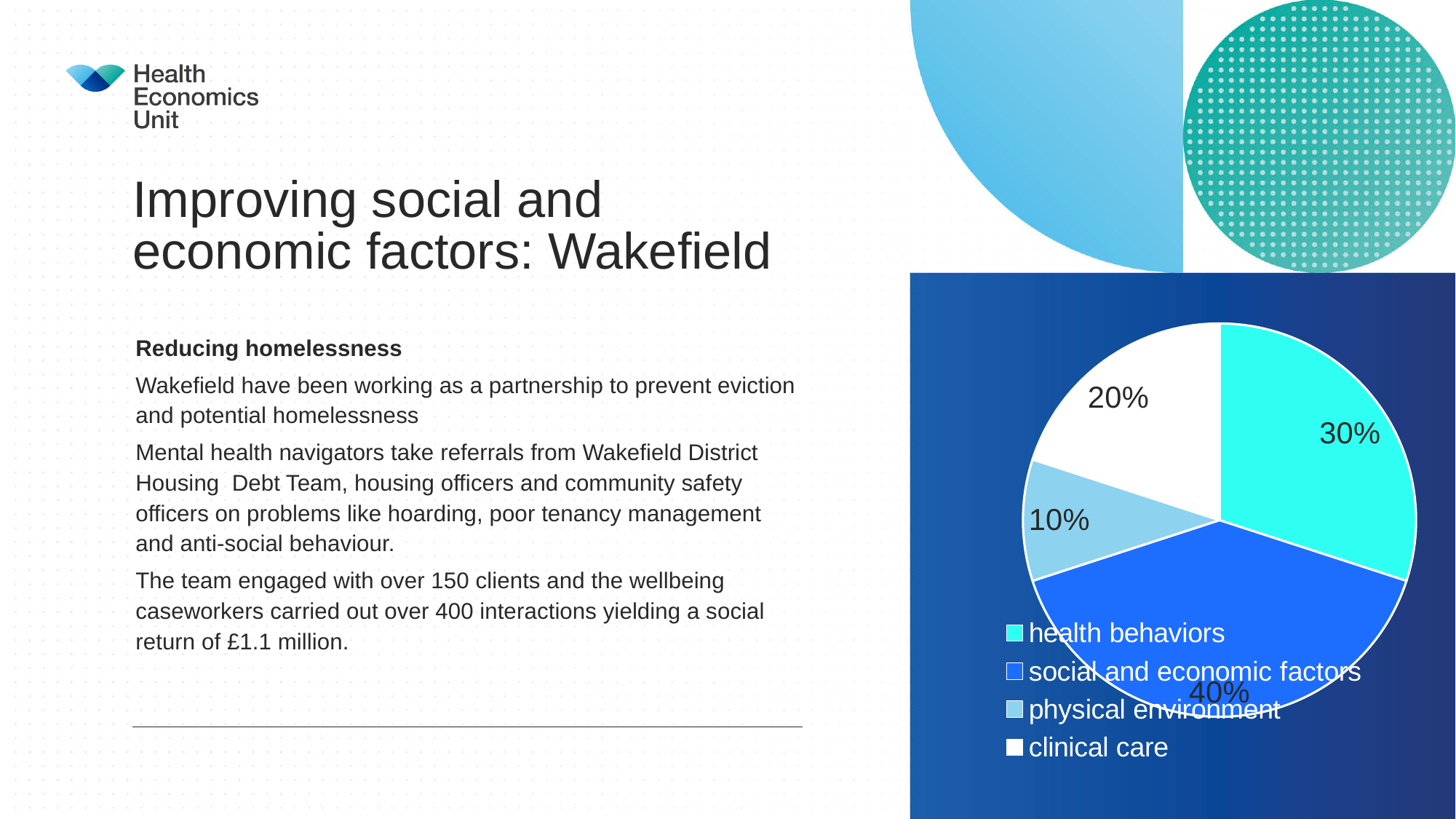
What colour is the slice for clinical care? white What share of the pie does health behaviors account for? 30% How many slices does the pie chart have? 4 What kind of chart is shown on the slide? pie chart What share of the pie does physical environment account for? 10% How many entries does the legend list? 4 Which category has the smallest slice of the pie? physical environment What is the difference between the shares for social and economic factors and clinical care? 20% What share of the pie does clinical care account for? 20% Which category has the largest slice of the pie? social and economic factors What share of the pie does social and economic factors account for? 40% Which is larger, the share for health behaviors or the share for clinical care? health behaviors